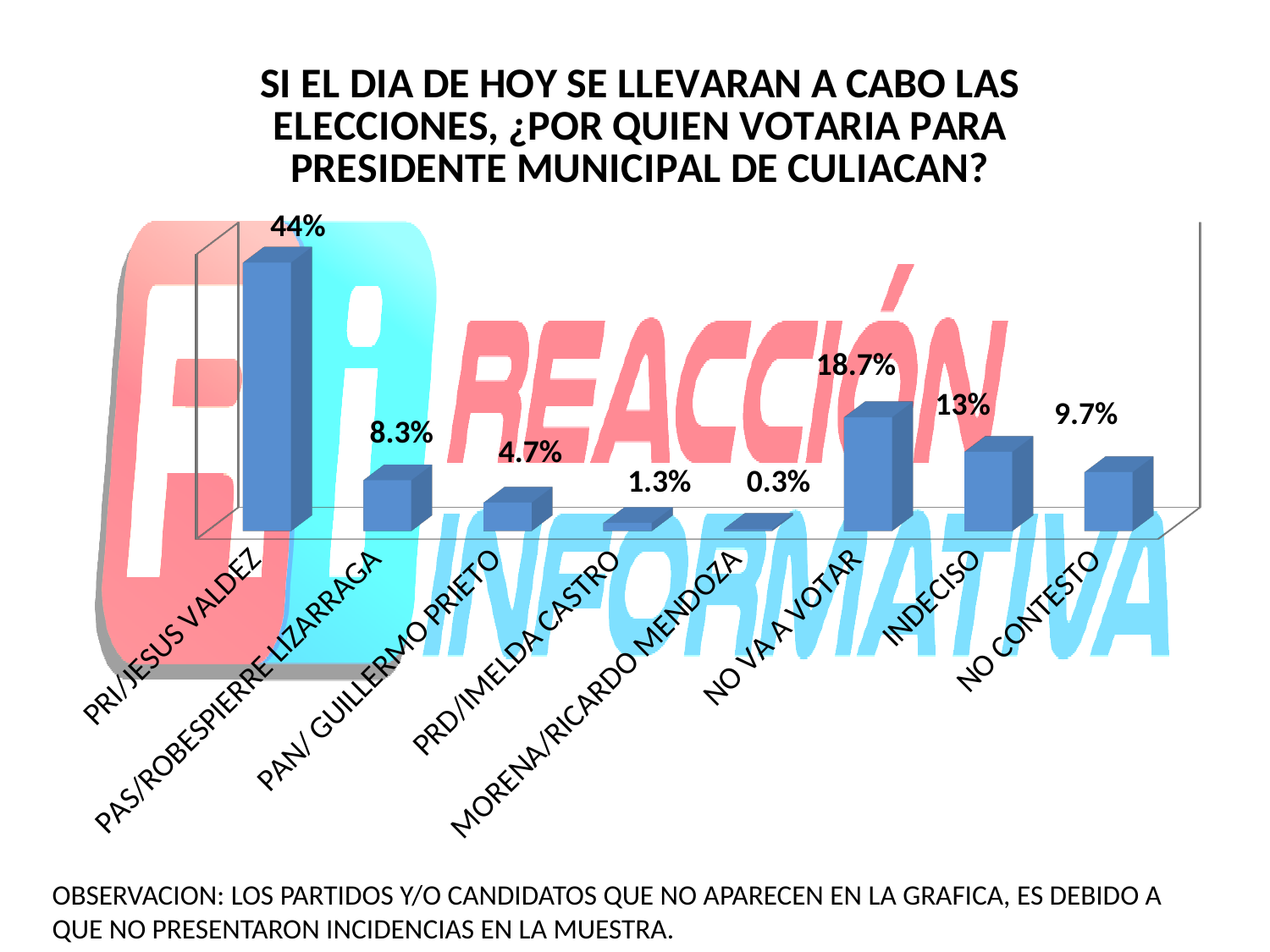
What is the title of the chart? SI EL DIA DE HOY SE LLEVARAN A CABO LAS ELECCIONES, ¿POR QUIEN VOTARIA PARA PRESIDENTE MUNICIPAL DE CULIACAN? What is the value for PRI/JESUS VALDEZ? 44% What is the difference between the values for INDECISO and NO CONTESTO? 3.3% What is the difference between the values for PRI/JESUS VALDEZ and NO VA A VOTAR? 25.3% Which category has the highest value? PRI/JESUS VALDEZ What kind of chart is shown on the slide? Bar chart What is the value for MORENA/RICARDO MENDOZA? 0.3% Which category has the lowest value? MORENA/RICARDO MENDOZA What is the value for PAS/ROBESPIERRE LIZARRAGA? 8.3% Which is larger, the value for PAN/ GUILLERMO PRIETO or the value for PRD/IMELDA CASTRO? PAN/ GUILLERMO PRIETO How many categories are shown in the chart? 8 What is the value for NO VA A VOTAR? 18.7%